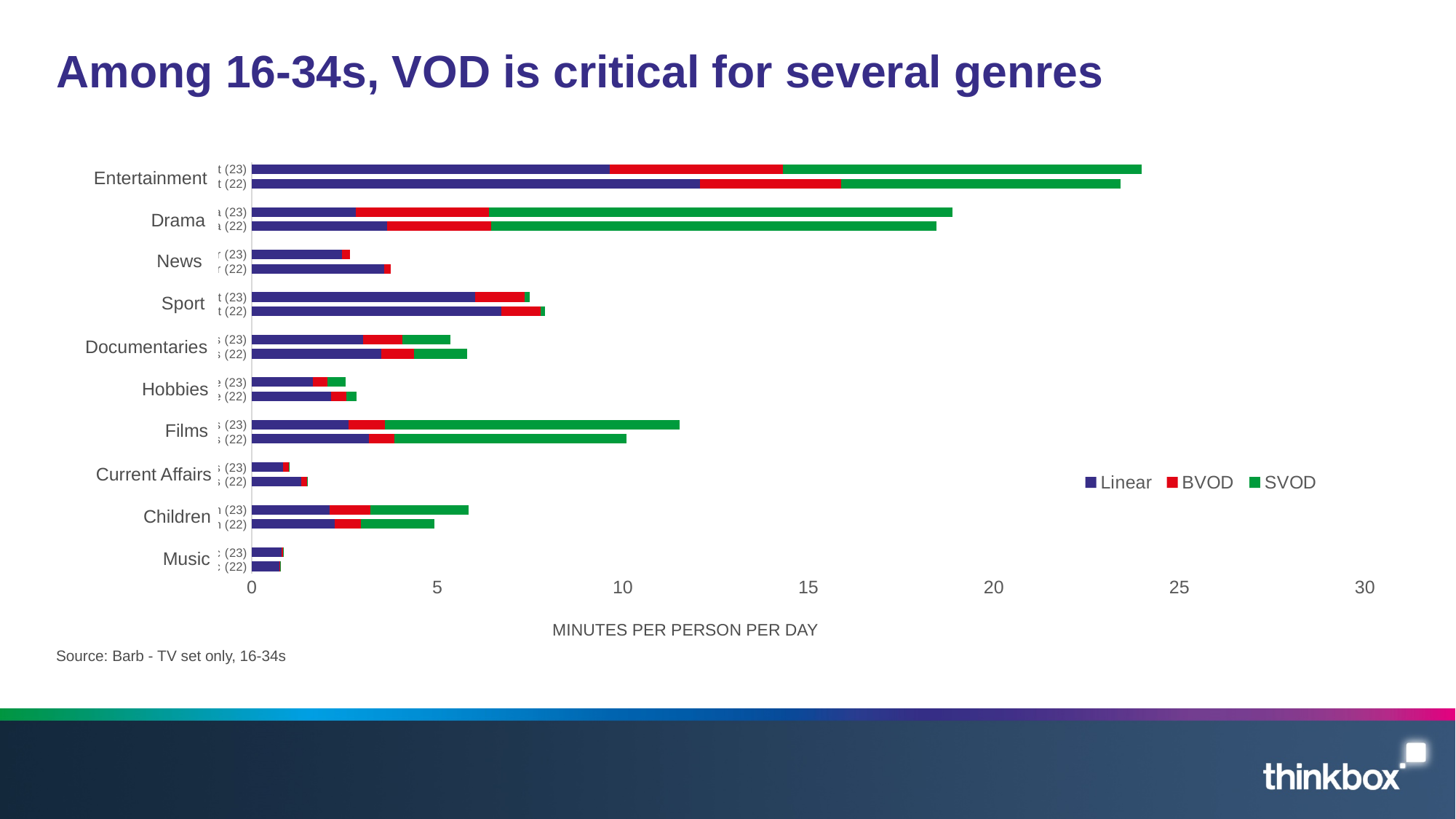
Is the total value for the Entertainment (23) bar greater or less than 20? greater Is the total value for the News (23) bar greater or less than 5? less How many series does the legend list? 3 Which genre has the longest bars on the chart? Entertainment Which has a longer total bar, Drama (23) or Films (23)? Drama (23) What kind of chart is shown on the slide? Bar chart Is the total value for the Films (23) bar greater or less than 10? greater Which has a longer total bar, Films (23) or Sport (23)? Films (23) What is the title of the horizontal axis? MINUTES PER PERSON PER DAY How many genres are shown on the chart? 10 Which genre has the shortest bars on the chart? Music